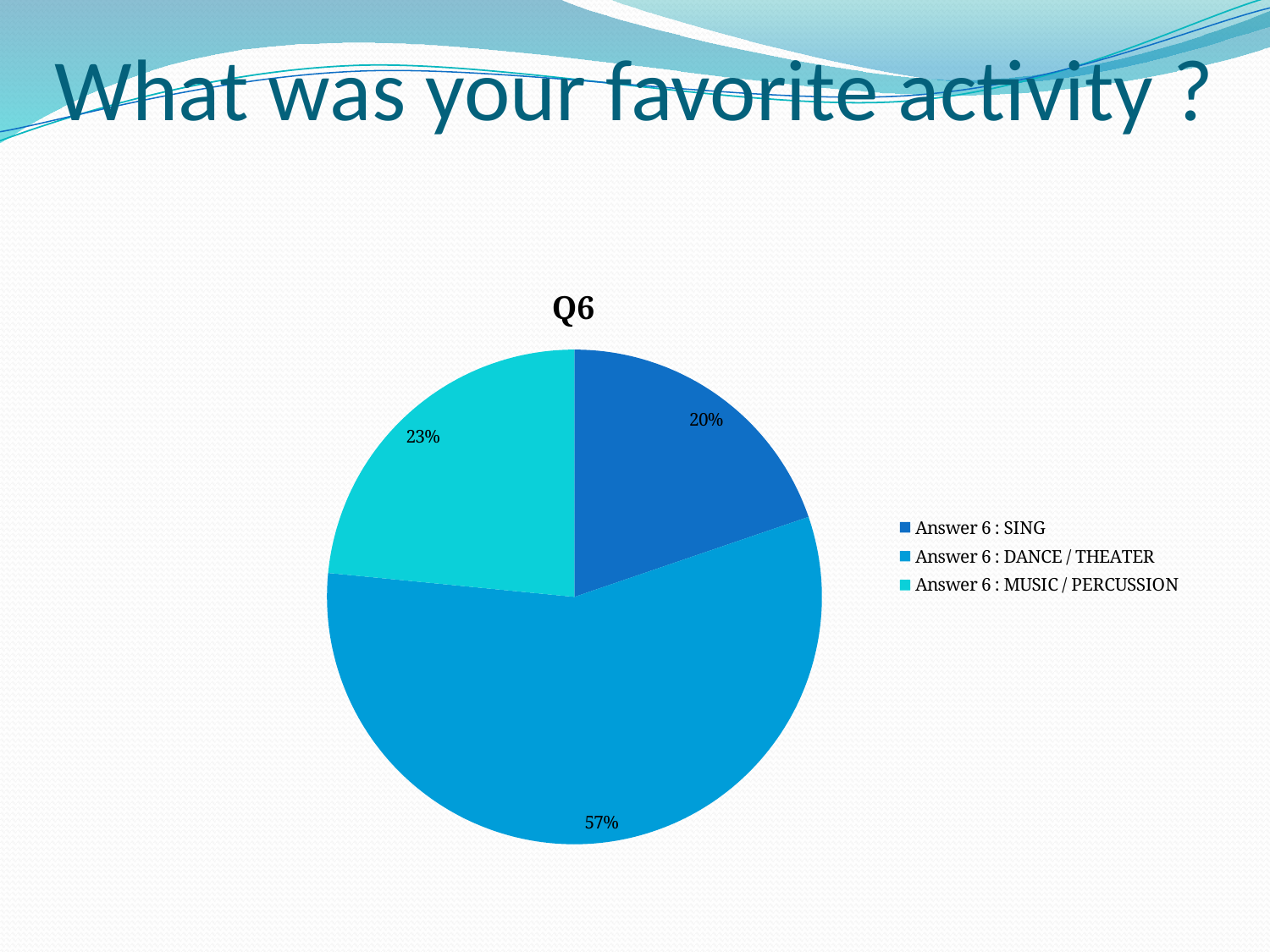
What is the difference in percentage points between Answer 6 : MUSIC / PERCUSSION and Answer 6 : SING? 3 Which is larger, the share for Answer 6 : MUSIC / PERCUSSION or the share for Answer 6 : SING? Answer 6 : MUSIC / PERCUSSION How many slices does the pie chart have? 3 What percentage of the pie is Answer 6 : DANCE / THEATER? 57% Which category has the smallest share of the pie? Answer 6 : SING What is the chart's title? Q6 What percentage of the pie is Answer 6 : MUSIC / PERCUSSION? 23% How many entries does the legend list? 3 What percentage of the pie is Answer 6 : SING? 20% What type of chart is shown on the slide? pie chart What is the difference in percentage points between Answer 6 : DANCE / THEATER and Answer 6 : MUSIC / PERCUSSION? 34 Which category has the largest share of the pie? Answer 6 : DANCE / THEATER